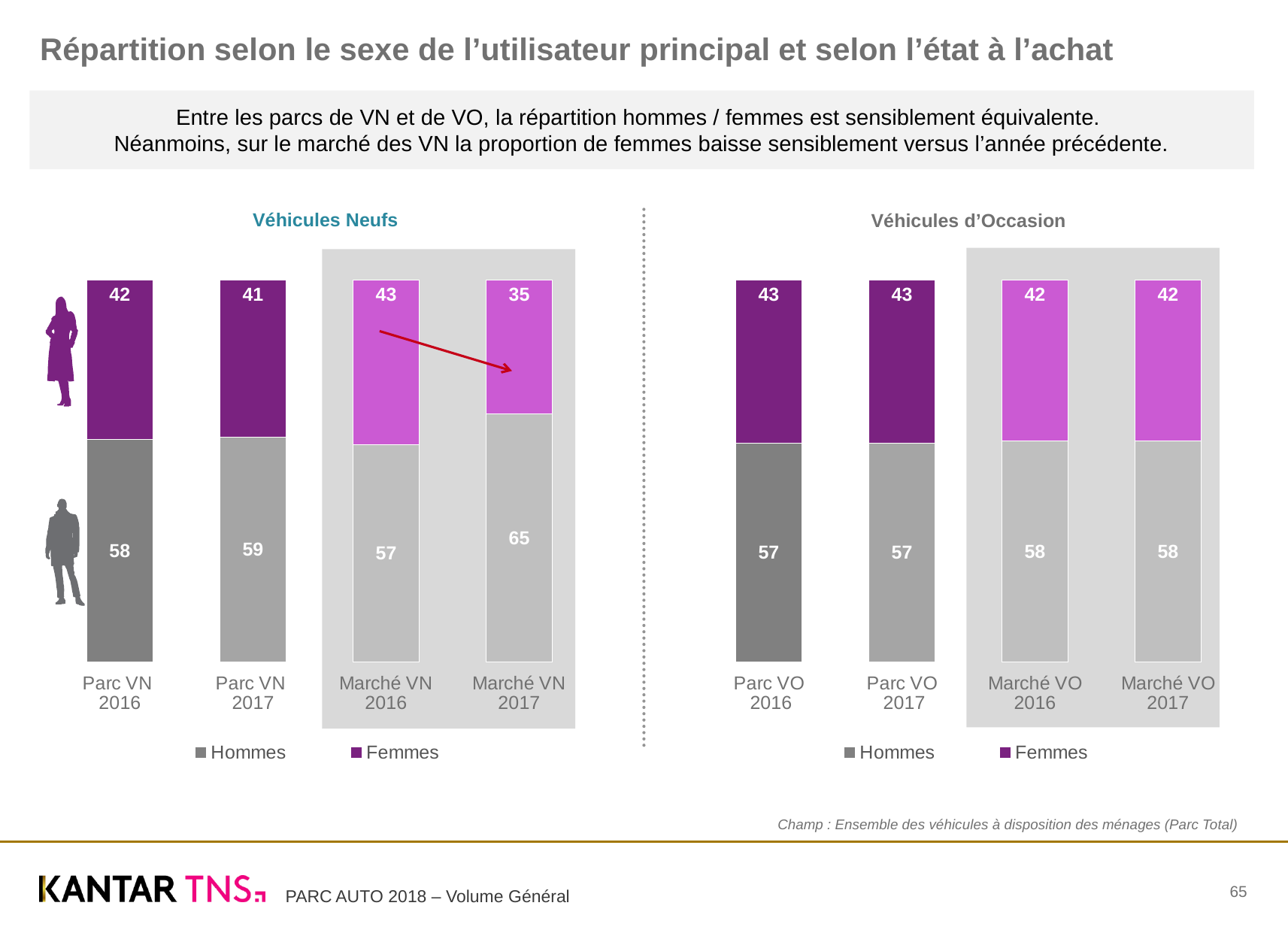
In the 'Véhicules Neufs' chart, what is the value for Femmes in Marché VN 2017? 35 In the 'Véhicules d'Occasion' chart, is the Hommes value for Parc VO 2016 larger or smaller than the Femmes value for Parc VO 2016? larger In the 'Véhicules d'Occasion' chart, what is the value for Femmes in Parc VO 2016? 43 In the 'Véhicules Neufs' chart, what is the value for Hommes in Parc VN 2017? 59 In the 'Véhicules d'Occasion' chart, what is the value for Hommes in Marché VO 2017? 58 In the 'Véhicules Neufs' chart, what is the difference between the Femmes values for Marché VN 2016 and Marché VN 2017? 8 In the 'Véhicules Neufs' chart, which category has the lowest Femmes value? Marché VN 2017 In the 'Véhicules Neufs' chart, which category has the highest Hommes value? Marché VN 2017 What kind of chart is the 'Véhicules Neufs' chart? Stacked bar chart How many categories are shown in the 'Véhicules d'Occasion' chart? 4 How many series does the legend of the 'Véhicules Neufs' chart list? 2 In the 'Véhicules Neufs' chart, what is the total of the stacked bar for Marché VN 2017? 100